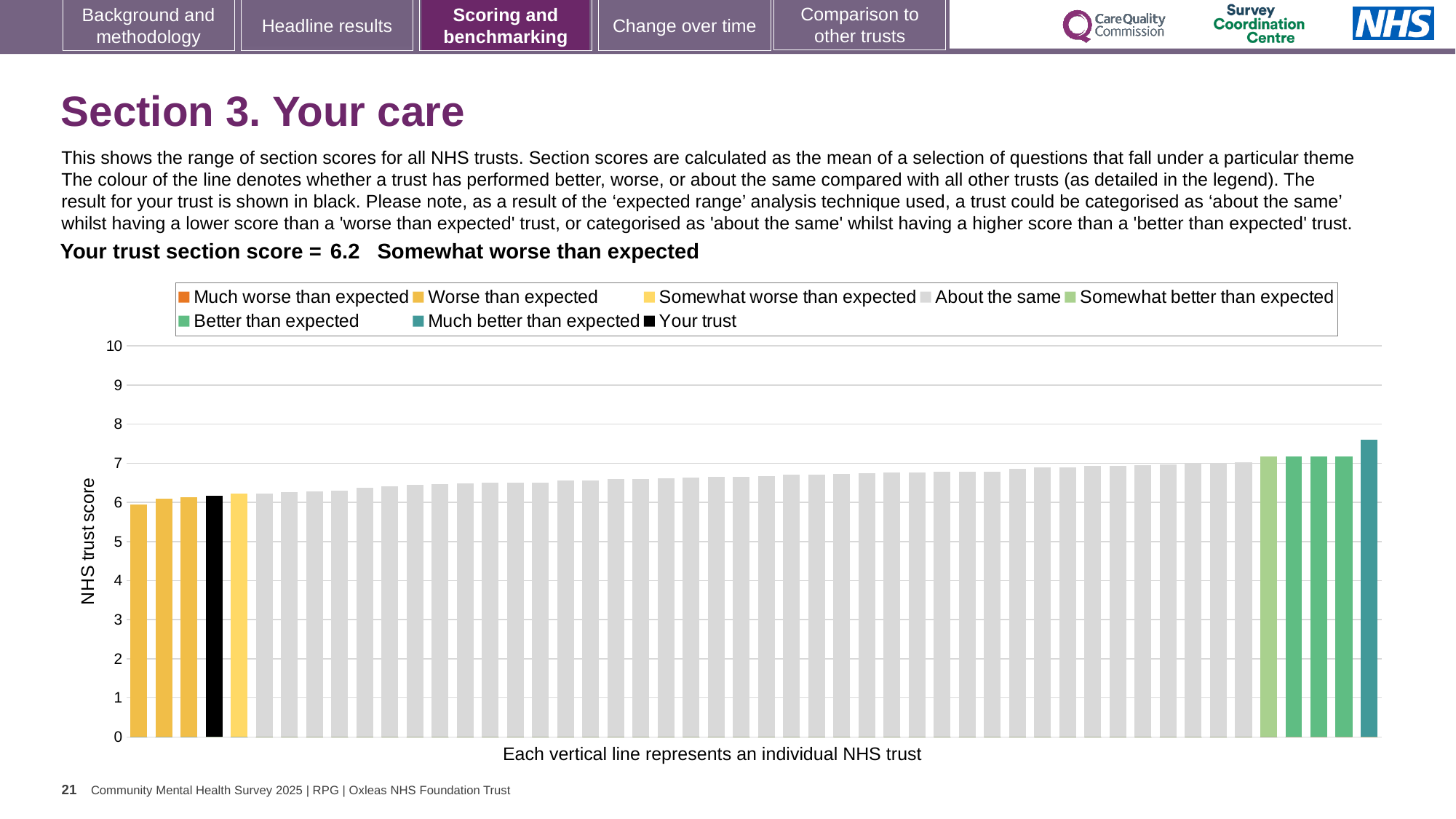
How many entries does the chart legend list? 8 What is the section score for your trust shown on the slide? 6.2 What colour is the bar representing your trust? black What kind of chart is used to show the NHS trust section scores? bar chart Is the highest bar on the chart greater or less than 7? greater Which performance category is your trust placed in for this section? Somewhat worse than expected Is the value for your trust greater or less than 7? less Is the lowest bar on the chart greater or less than 5? greater What is the label on the vertical axis of the chart? NHS trust score Do the bar values rise or fall from left to right across the chart? rise